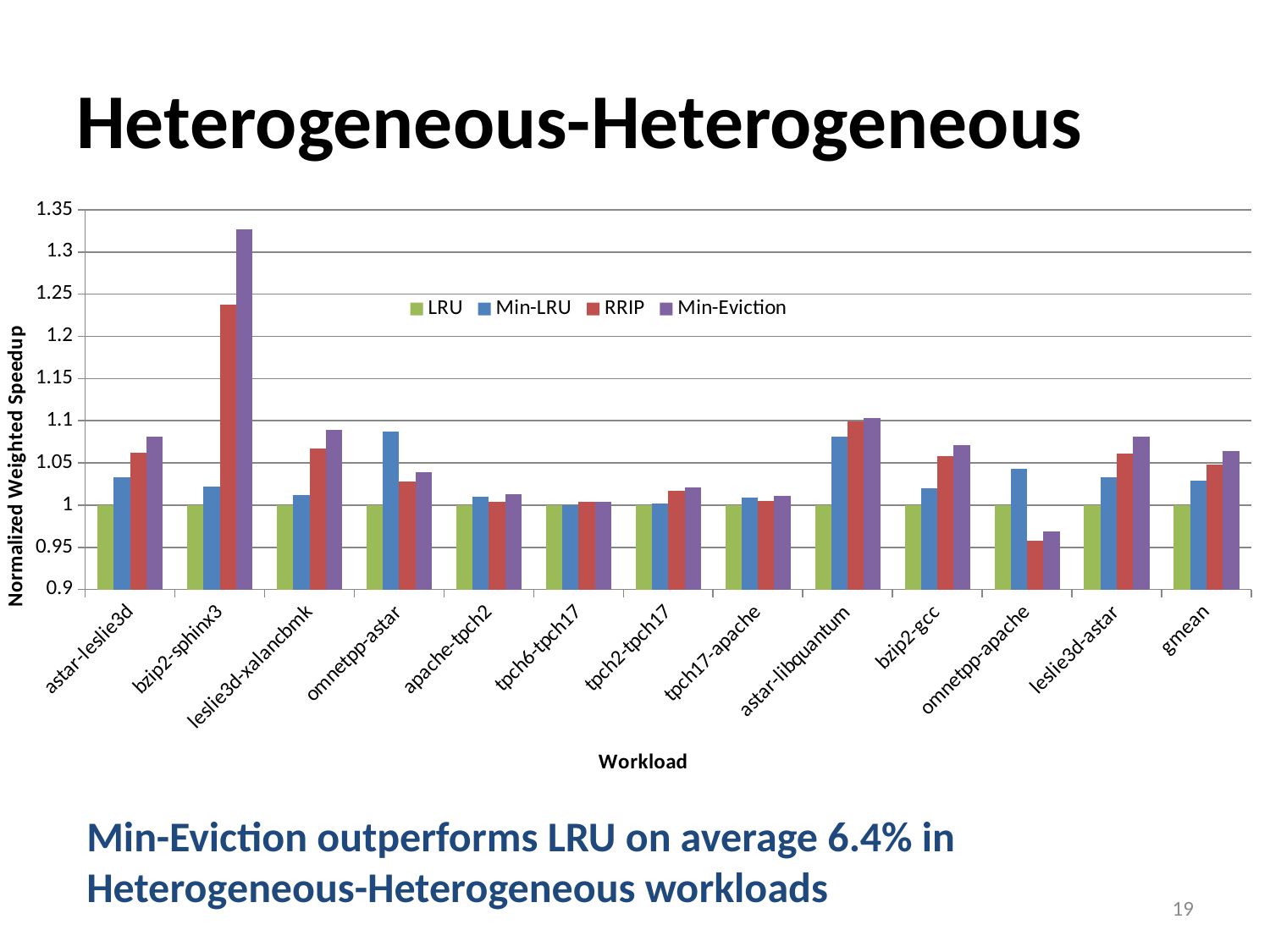
Which workload has the lowest RRIP bar? omnetpp-apache Is the Min-Eviction value for bzip2-sphinx3 greater or less than 1.3? greater What is the Normalized Weighted Speedup for LRU on the astar-leslie3d workload? 1 How many series does the legend list? 4 For the omnetpp-astar workload, which is larger: the Min-LRU bar or the RRIP bar? Min-LRU What kind of chart is shown on the slide? bar chart Which series is shown in green in the legend? LRU Is the RRIP value for omnetpp-apache greater or less than 1? less Is the Min-LRU value for omnetpp-astar greater or less than 1.05? greater What is the label of the y axis? Normalized Weighted Speedup How many workload categories are shown on the x axis? 13 Which workload has the highest Min-Eviction bar? bzip2-sphinx3